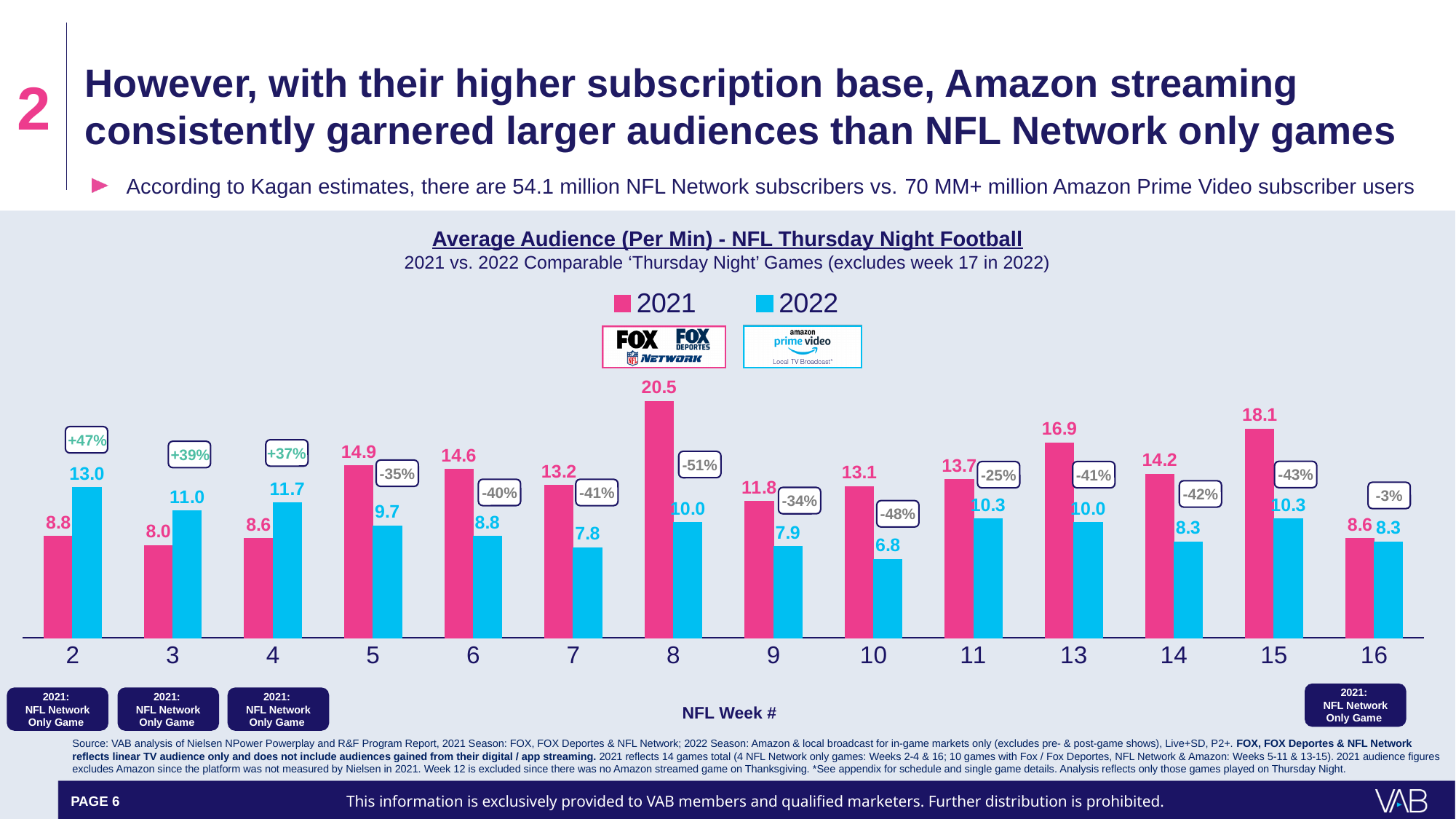
What was the 2021 average audience for NFL week 8? 20.5 How many NFL weeks are shown on the x axis of the chart? 14 How many series does the chart legend list? 2 What was the 2022 average audience for NFL week 10? 6.8 Which NFL week has the highest 2021 average audience? 8 What percentage change is labeled for NFL week 2? +47% What kind of chart is shown on the slide? Bar chart What percentage change is labeled for NFL week 16? -3% Which NFL week has the lowest 2022 average audience? 10 Which year is represented by the pink bars in the chart? 2021 What is the difference between the 2021 and 2022 average audience for NFL week 15? 7.8 For NFL week 3, which year had the larger average audience, 2021 or 2022? 2022